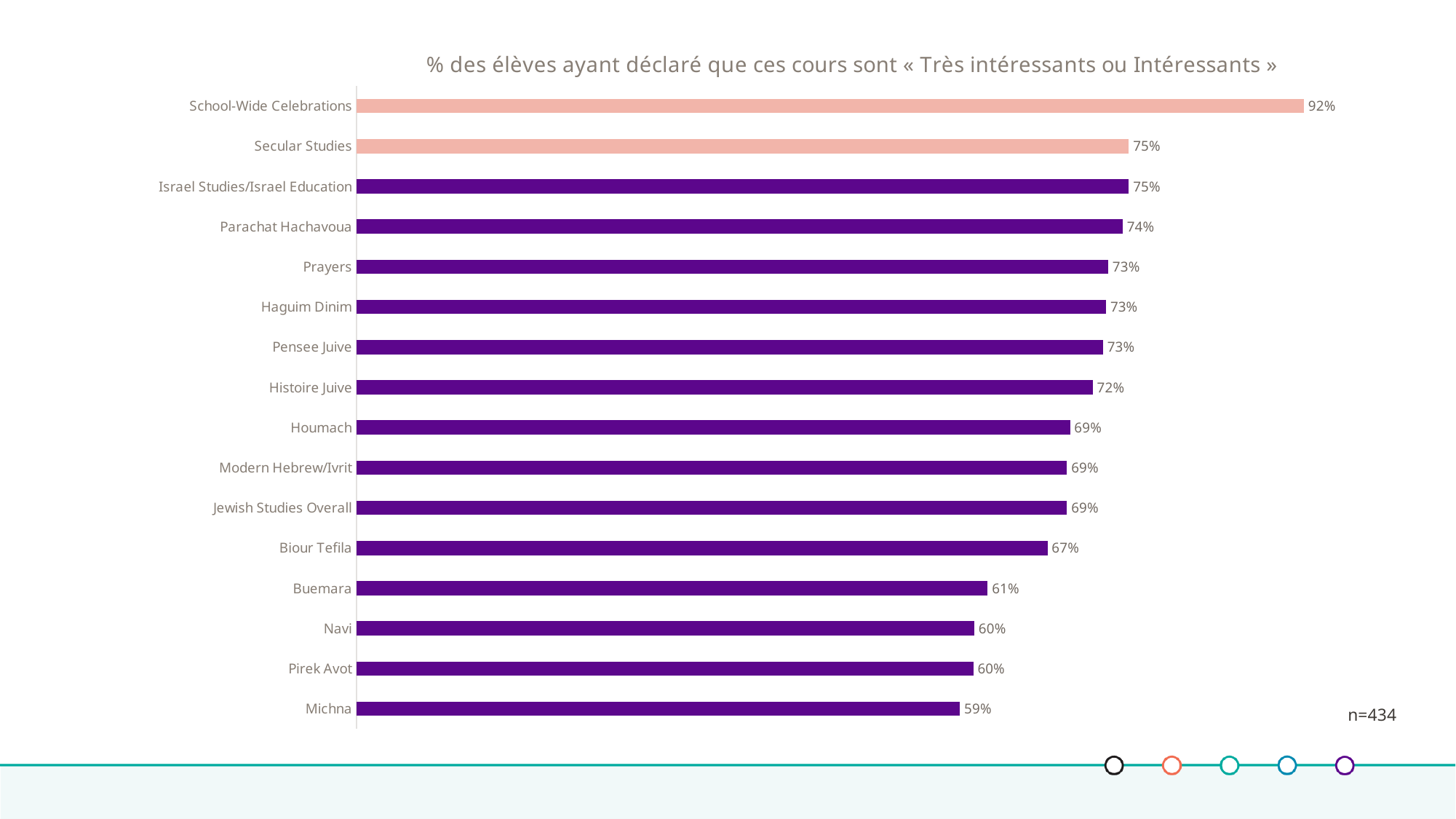
Which category has the lowest value? Michna Which has a higher value, Histoire Juive or Houmach? Histoire Juive What is the value shown for Parachat Hachavoua? 74% Which category has the highest value? School-Wide Celebrations What sample size (n) is noted on the slide? n=434 What kind of chart is shown on the slide? Bar chart What is the value shown for Michna? 59% What is the difference between the values for School-Wide Celebrations and Secular Studies? 17% How many categories are shown in the chart? 16 What is the difference between the values for Buemara and Michna? 2% What is the value shown for Biour Tefila? 67% What percentage of students rated School-Wide Celebrations as very interesting or interesting? 92%